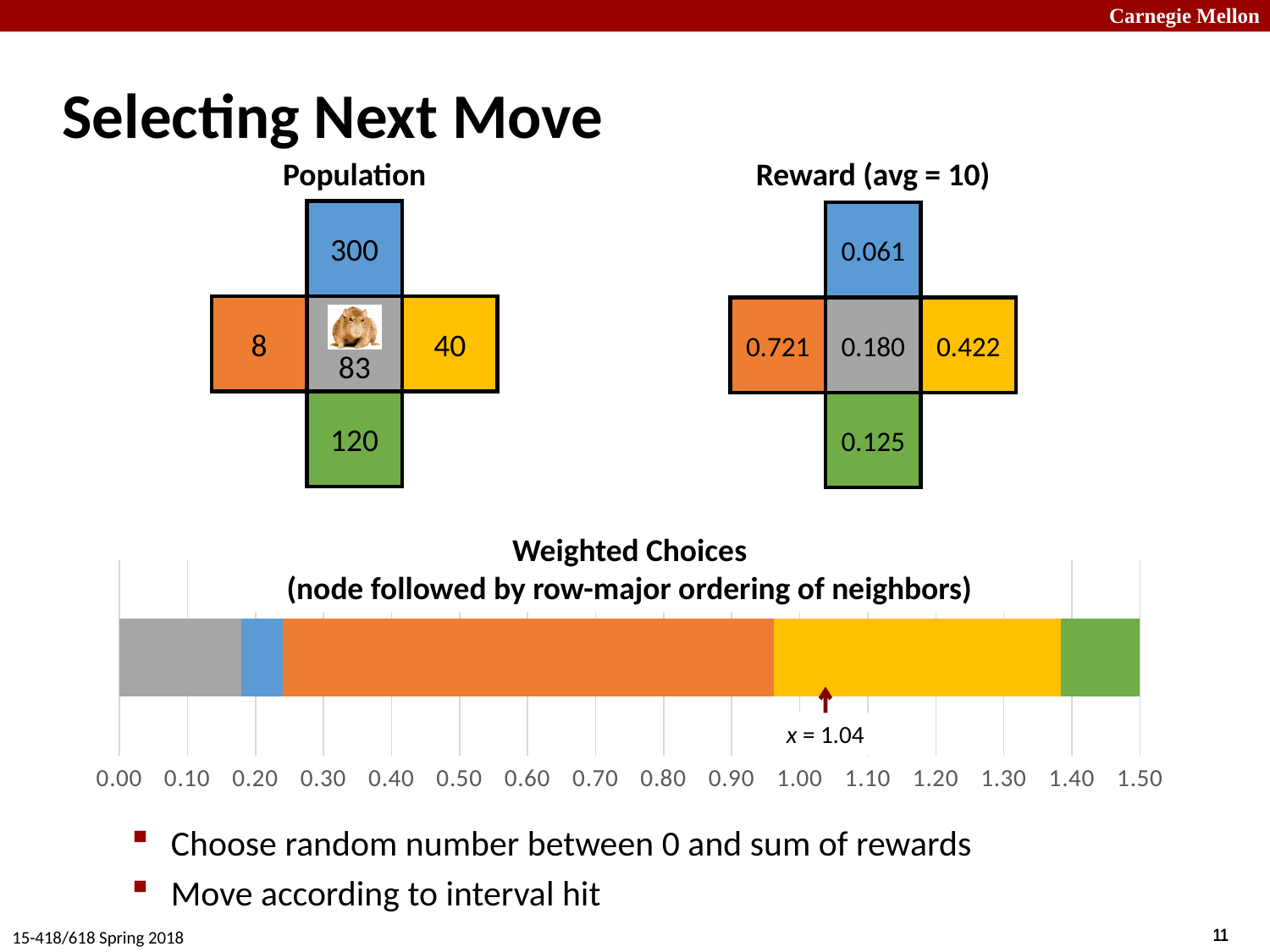
How many coloured segments make up the bar in the Weighted Choices chart? 5 In the Weighted Choices chart, is the right end of the orange segment greater or less than 0.90? greater In the Weighted Choices chart, is the right end of the whole bar greater or less than 1.40? greater What value of x is marked by the arrow under the bar in the Weighted Choices chart? x = 1.04 What is the largest tick value shown on the x axis of the Weighted Choices chart? 1.50 In the Weighted Choices chart, is the left end of the green segment greater or less than 1.30? greater In the Weighted Choices chart, which coloured segment is the narrowest? blue In the Weighted Choices chart, which segment is wider, the yellow one or the green one? yellow In the Weighted Choices chart, which coloured segment is the widest? orange What kind of chart is the Weighted Choices chart? bar chart In the Weighted Choices chart, which coloured segment does the arrow marked x = 1.04 point into? yellow